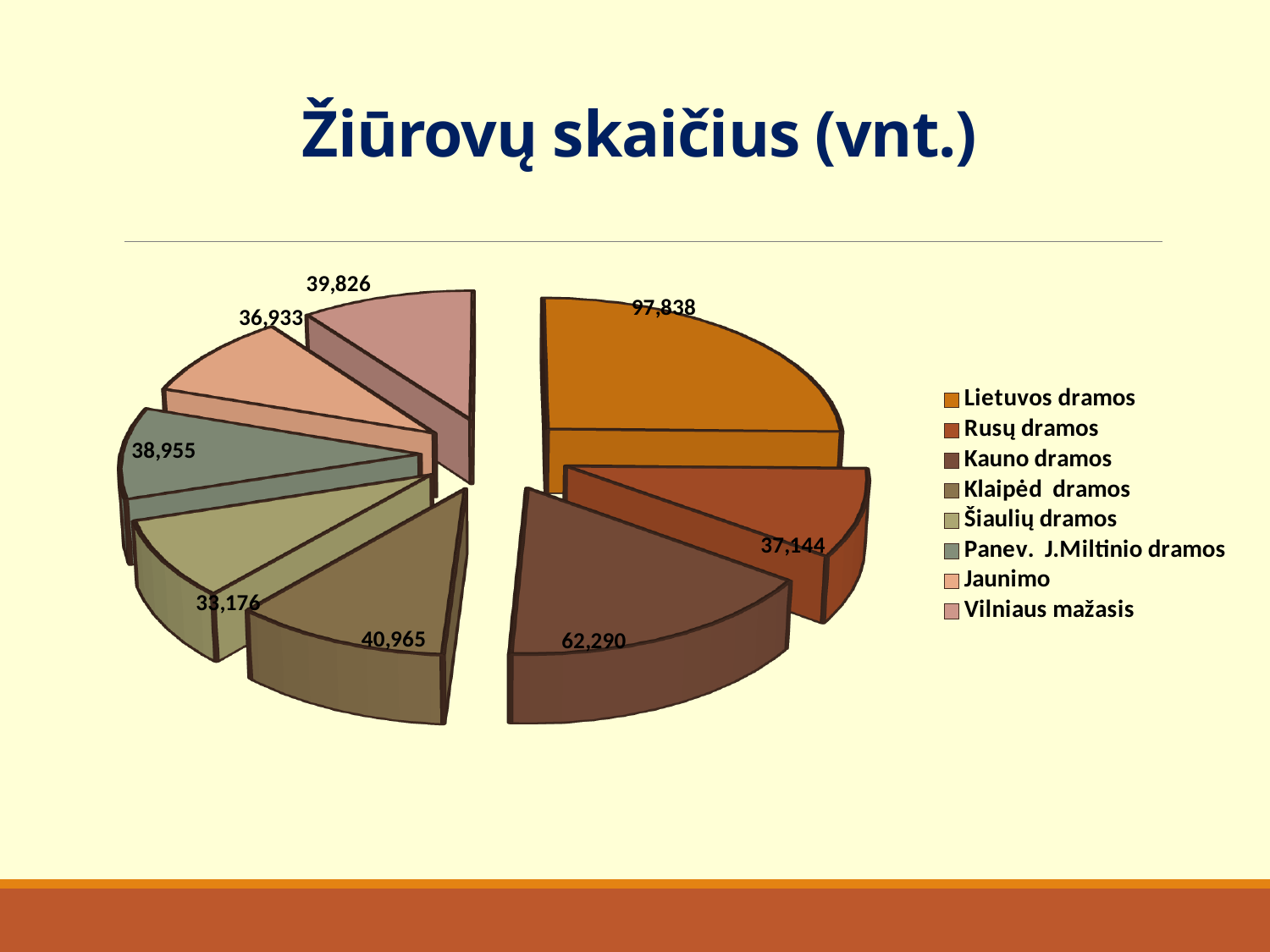
Which theatre has the highest number of viewers? Lietuvos dramos Which legend entry is listed last? Vilniaus mažasis Which theatre has the lowest number of viewers? Šiaulių dramos What is the title of the chart? Žiūrovų skaičius (vnt.) How many slices does the pie chart have? 8 What is the value for Kauno dramos? 62,290 What type of chart is shown on the slide? Pie chart Which is larger, the value for Klaipėd dramos or the value for Rusų dramos? Klaipėd dramos What is the value for Vilniaus mažasis? 39,826 What is the value for Lietuvos dramos? 97,838 What is the difference between the values for Lietuvos dramos and Kauno dramos? 35,548 What is the value for Šiaulių dramos? 33,176